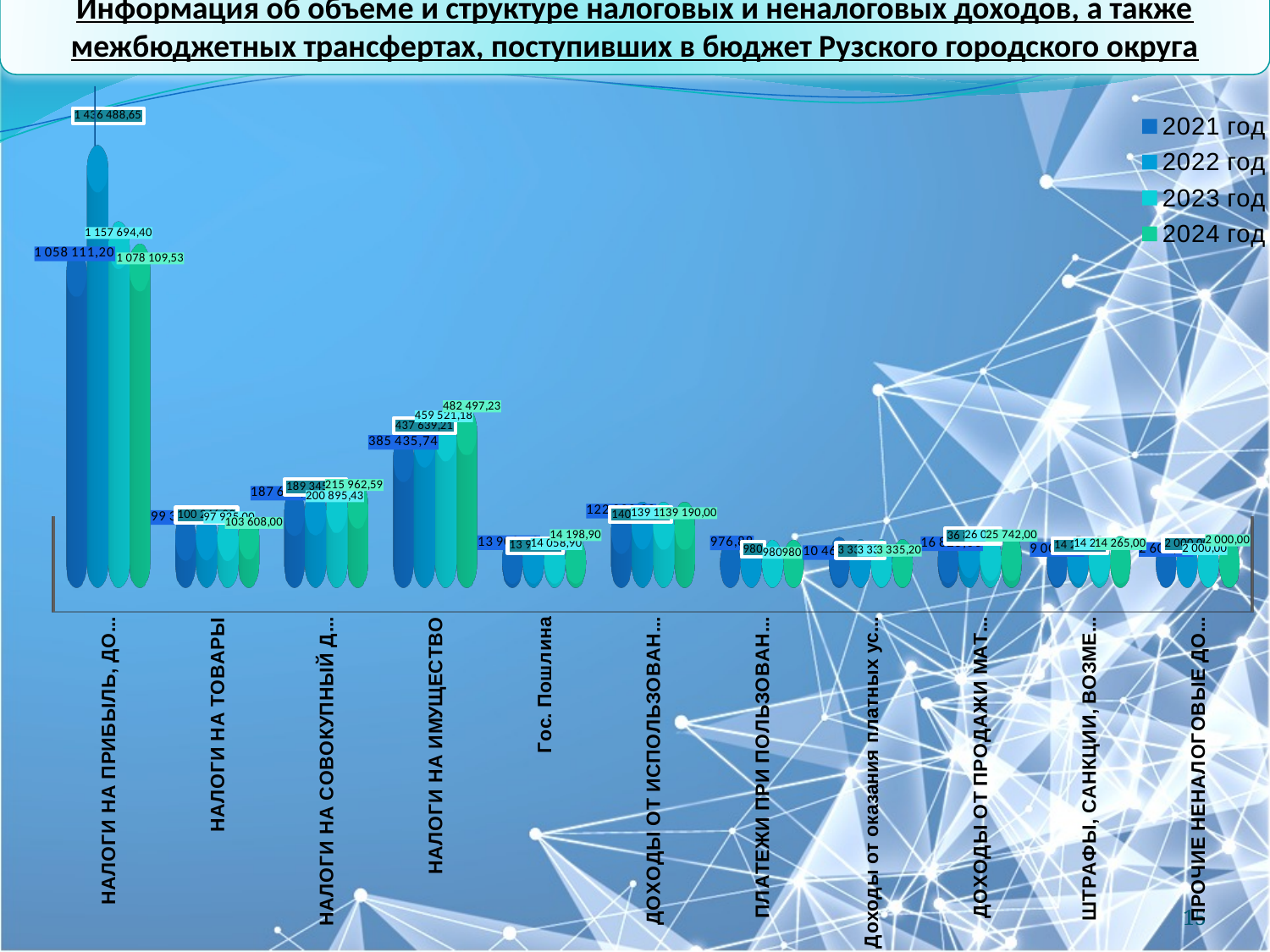
How many categories are shown along the x axis? 11 Do the values for НАЛОГИ НА ИМУЩЕСТВО rise or fall from 2021 год to 2024 год? Rise What is the value for 2024 год for НАЛОГИ НА ИМУЩЕСТВО? 482 497,23 How many series does the legend list? 4 Which category has the highest values overall? НАЛОГИ НА ПРИБЫЛЬ... What is the value for 2024 год for НАЛОГИ НА ТОВАРЫ? 103 608,00 Which years are listed in the legend? 2021 год, 2022 год, 2023 год, 2024 год What kind of chart is shown on the slide? Bar chart Which year has the highest value in the first category (НАЛОГИ НА ПРИБЫЛЬ...)? 2022 год What is the value for 2022 год in the first category (НАЛОГИ НА ПРИБЫЛЬ...)? 1 436 488,65 What is the value for 2024 год for Гос. Пошлина? 14 198,90 What is the difference between the 2024 год and 2021 год values for НАЛОГИ НА ИМУЩЕСТВО? 97 061,49